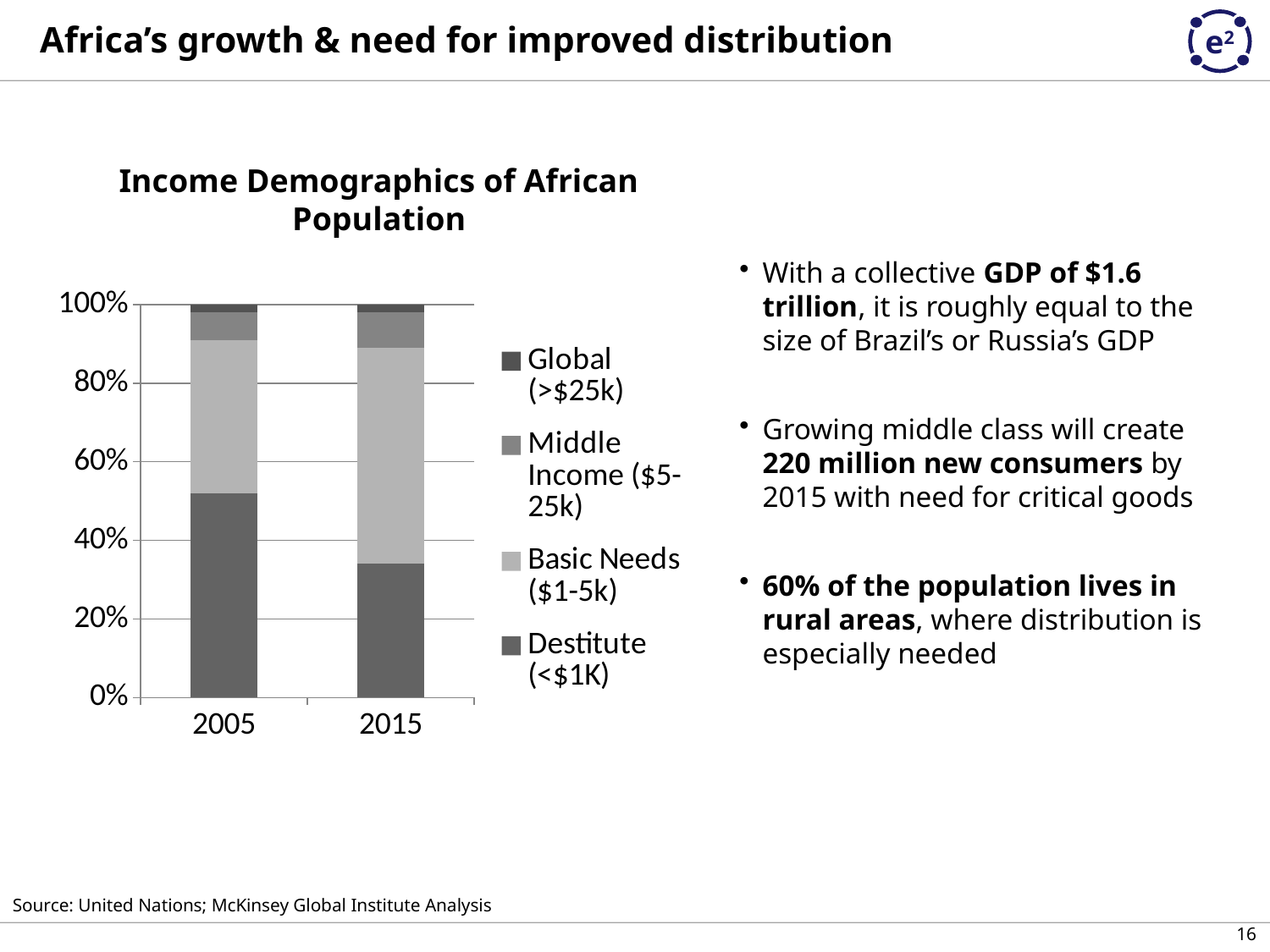
How many years (categories) are shown on the x axis of the chart? 2 Which year has the larger Destitute (<$1K) share, 2005 or 2015? 2005 Is the Destitute (<$1K) share in 2015 greater or less than 20%? greater Which year has the larger Basic Needs ($1-5k) share, 2005 or 2015? 2015 Is the Destitute (<$1K) share in 2005 greater or less than 60%? less Is the Destitute (<$1K) share in 2005 greater or less than 40%? greater What is the title of the chart? Income Demographics of African Population How many series does the chart's legend list? 4 Which legend entry represents the bottom segment of each bar? Destitute (<$1K) Does the Destitute (<$1K) share rise or fall from 2005 to 2015? fall What kind of chart is shown on the slide? Stacked bar chart